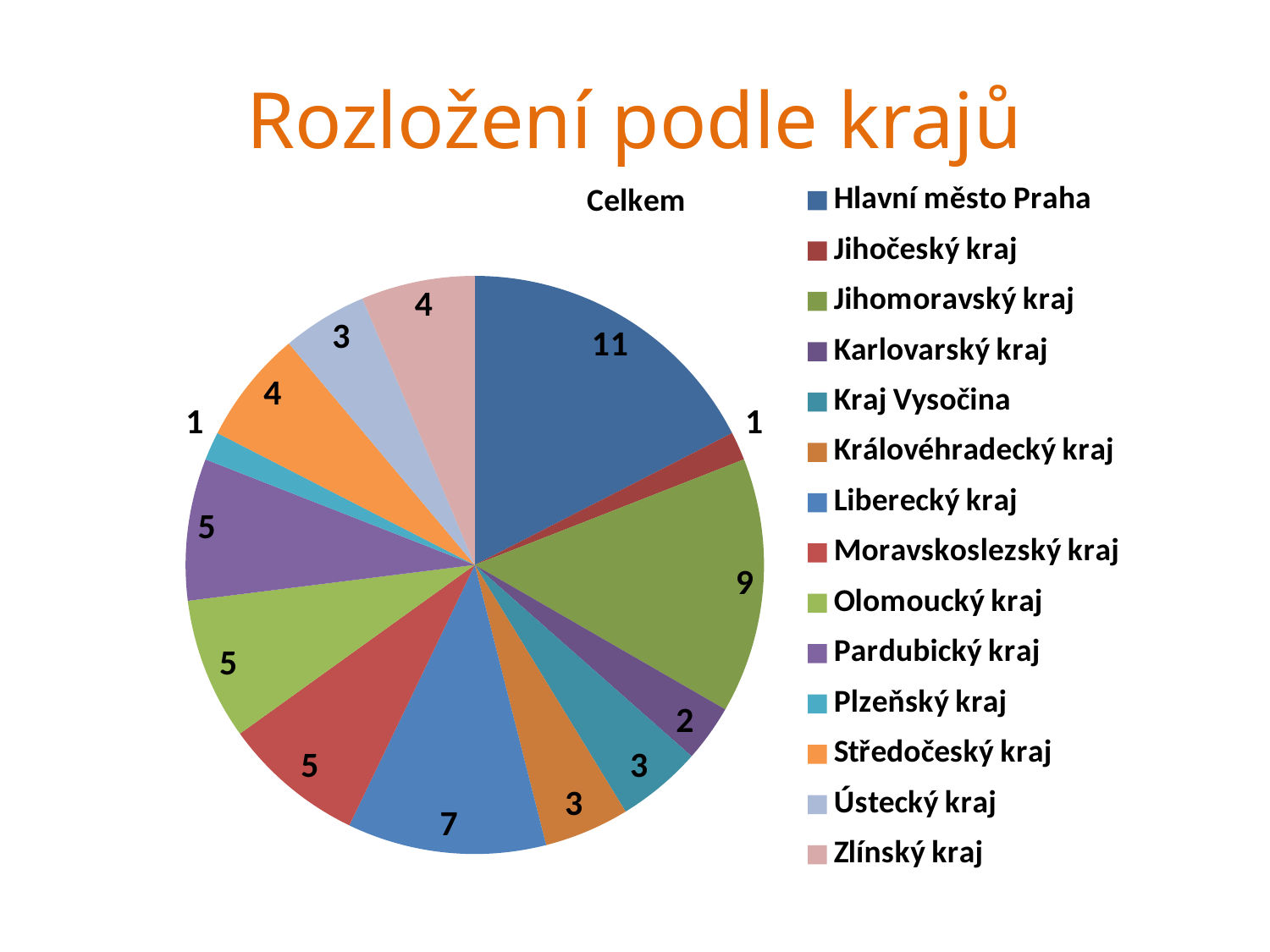
Which region has the largest slice of the pie? Hlavní město Praha What is the value for Karlovarský kraj? 2 What kind of chart is shown on the slide? pie chart Which is larger, the value for Liberecký kraj or for Moravskoslezský kraj? Liberecký kraj What is the value for Hlavní město Praha? 11 How many regions (slices) does the pie chart show? 14 What is the value for Liberecký kraj? 7 What is the value for Jihomoravský kraj? 9 What is the difference between the values for Hlavní město Praha and Jihomoravský kraj? 2 Which regions have the smallest value in the pie chart? Jihočeský kraj and Plzeňský kraj What is the title printed above the pie chart? Celkem What is the total of all the values shown in the pie chart? 63